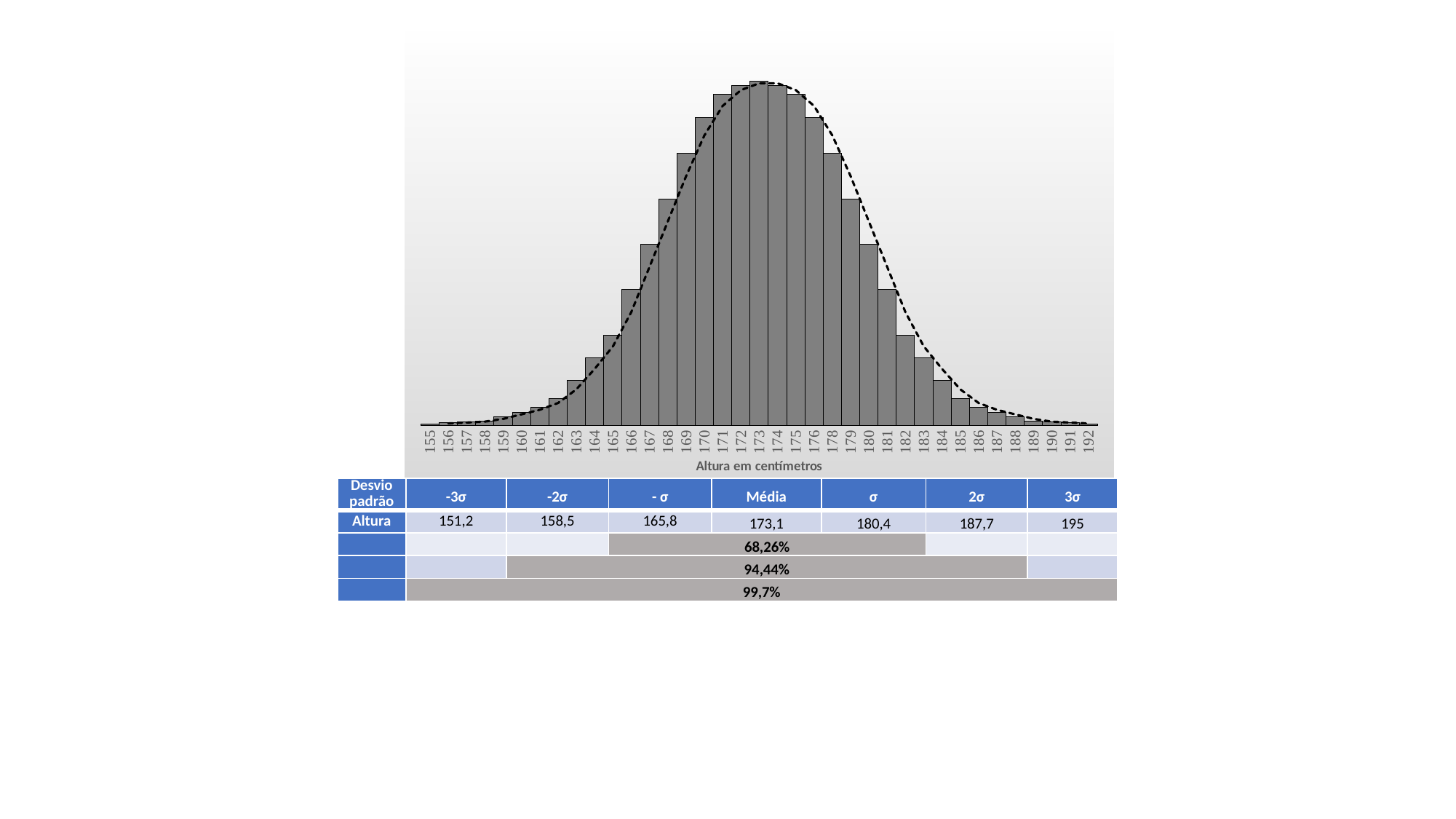
What is the title of the x axis of the chart? Altura em centímetros Which is shorter in the chart, the bar for 158 or the bar for 172? 158 Which is taller in the chart, the bar for 170 or the bar for 182? 170 What is the first category label on the x axis of the chart? 155 What kind of chart is shown on the slide? bar chart Which is taller in the chart, the bar for 165 or the bar for 180? 180 Do the bar heights rise or fall along the x axis from 155 to 170? rise Do the bar heights rise or fall along the x axis from 180 to 192? fall